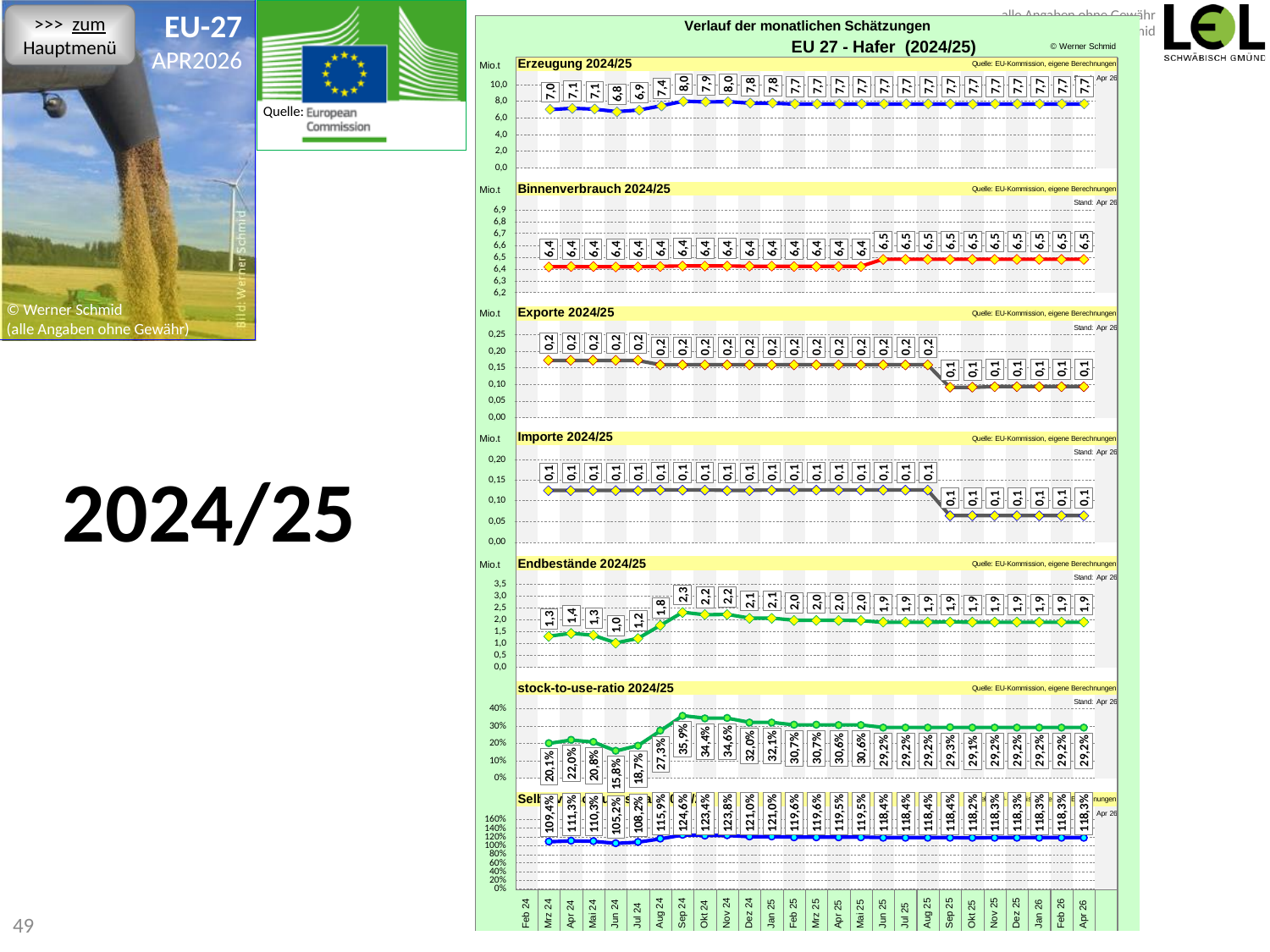
In the stock-to-use-ratio 2024/25 chart, what is the lowest value shown? 15,8% In the Erzeugung 2024/25 chart, what is the highest value shown? 8,0 In the Binnenverbrauch 2024/25 chart, what is the value of the last data point (Apr 26)? 6,5 In the Endbestände 2024/25 chart, what is the lowest value shown? 1,0 In the Binnenverbrauch 2024/25 chart, do the values rise or fall from the first to the last data point? rise In the Exporte 2024/25 chart, what is the value of the last data point (Apr 26)? 0,1 In the Endbestände 2024/25 chart, what is the difference between the highest and the lowest value? 1,3 In the Endbestände 2024/25 chart, what is the highest value shown? 2,3 In the Erzeugung 2024/25 chart, what is the lowest value shown? 6,8 In the Erzeugung 2024/25 chart, what is the value of the last data point (Apr 26)? 7,7 What kind of chart is the Erzeugung 2024/25 chart? line chart In the stock-to-use-ratio 2024/25 chart, what is the highest value shown? 35,9%